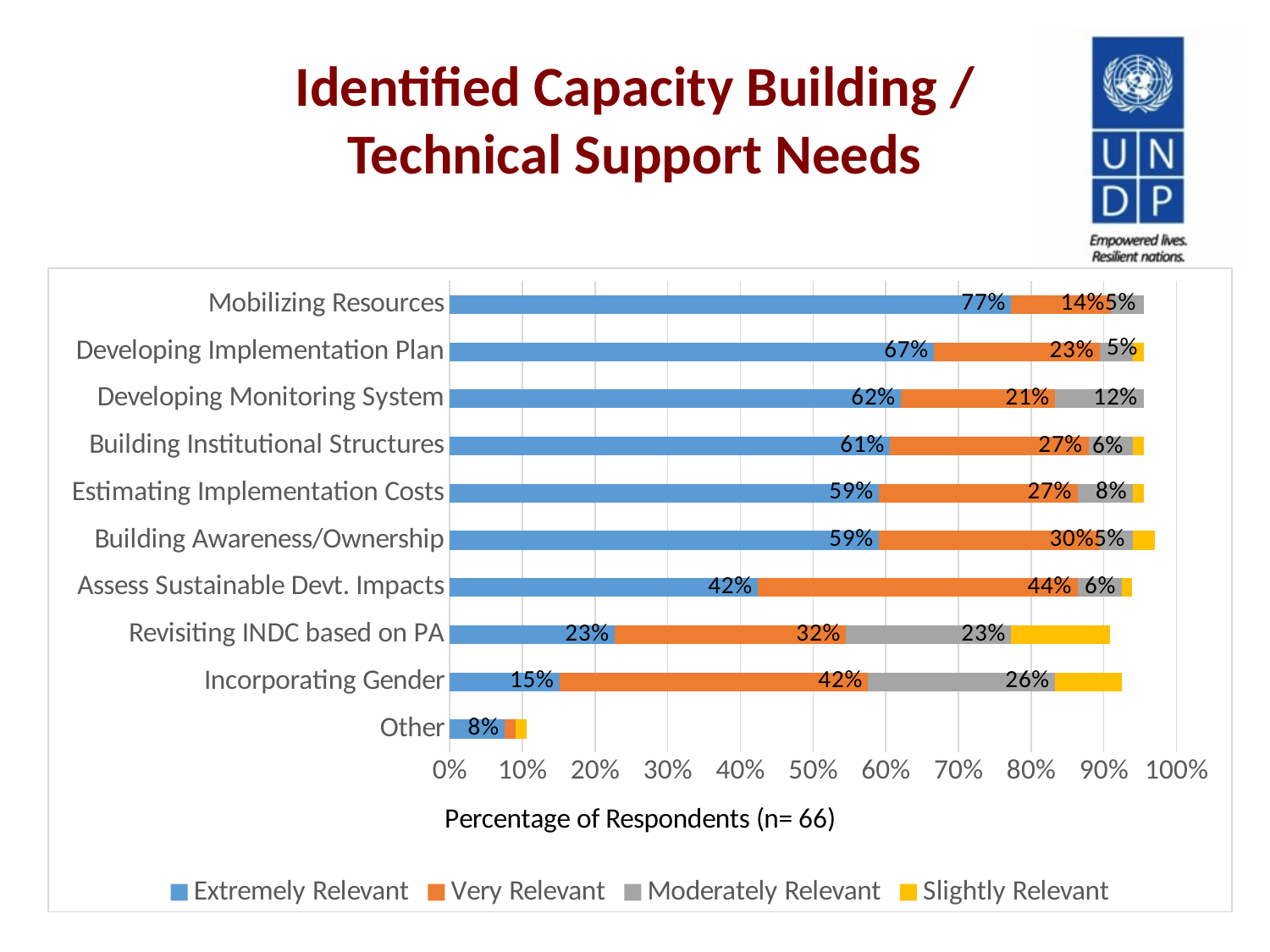
Which category has the highest Extremely Relevant percentage? Mobilizing Resources How many percentage points higher is the Extremely Relevant value for Mobilizing Resources than for Developing Implementation Plan? 10 percentage points How many capacity building / technical support need categories are listed on the chart? 10 What percentage of respondents rated Mobilizing Resources as Extremely Relevant? 77% What kind of chart is shown on the slide? Stacked bar chart Is the total length of the bar for Revisiting INDC based on PA greater or less than 80%? greater What is the title of the horizontal axis? Percentage of Respondents (n= 66) Which category has the lowest Extremely Relevant percentage? Other What is the Very Relevant value for Assess Sustainable Devt. Impacts? 44% What is the Moderately Relevant value for Developing Monitoring System? 12% Which has a larger Very Relevant value: Incorporating Gender or Revisiting INDC based on PA? Incorporating Gender How many series does the legend list? 4